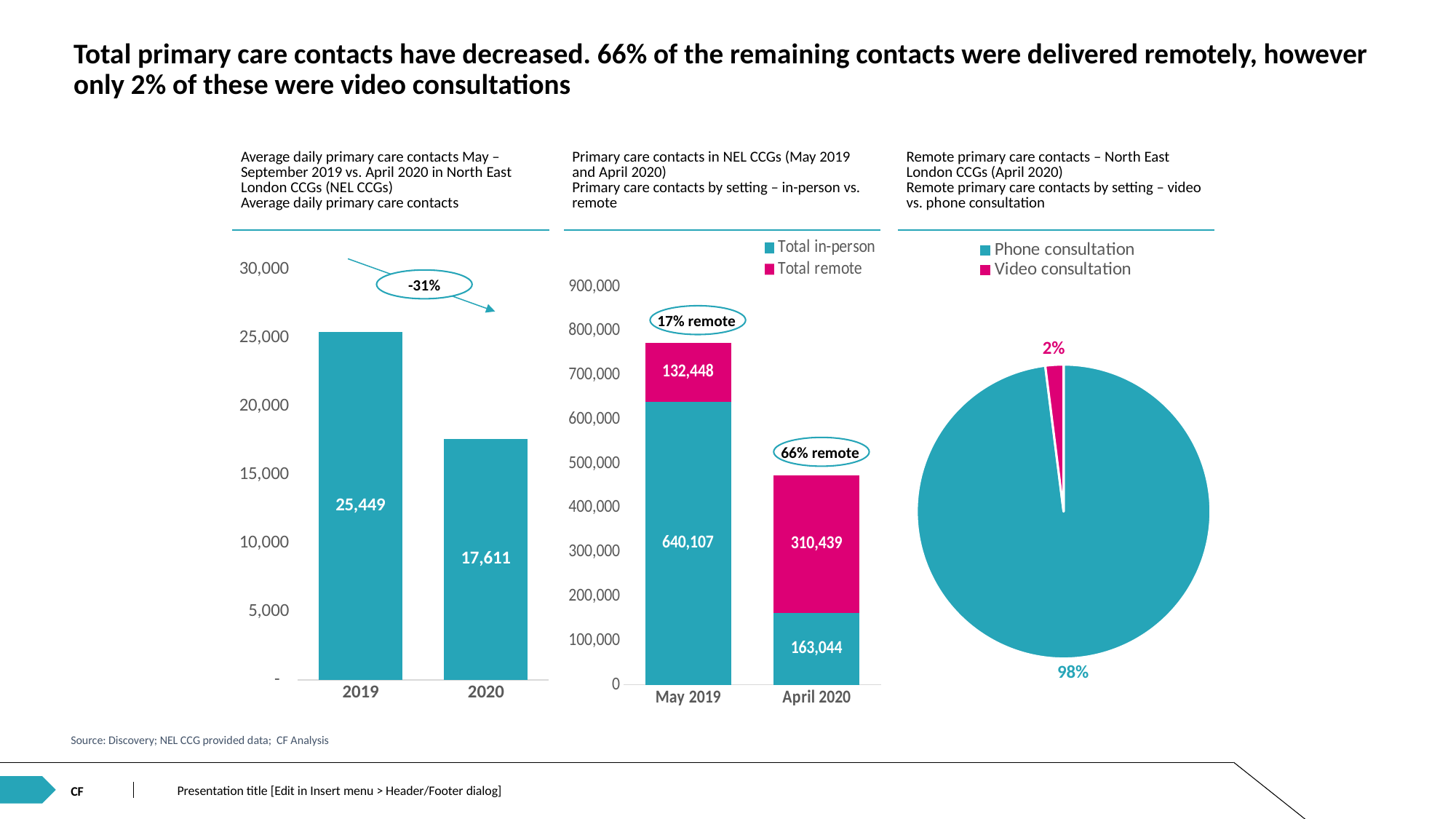
In the middle chart (Primary care contacts by setting), what is the total of the stacked bar for April 2020? 473,483 In the middle chart (Primary care contacts by setting), how many series does the legend list? 2 In the left chart (Average daily primary care contacts), what is the value for 2020? 17,611 In the middle chart (Primary care contacts by setting), what is the Total in-person value for April 2020? 163,044 In the middle chart (Primary care contacts by setting), what is the Total remote value for May 2019? 132,448 In the left chart (Average daily primary care contacts), what is the value for 2019? 25,449 In the middle chart (Primary care contacts by setting), what is the total of the stacked bar for May 2019? 772,555 What kind of chart is the right chart (Remote primary care contacts by setting)? pie chart In the left chart (Average daily primary care contacts), do the values rise or fall from 2019 to 2020? fall In the right chart (Remote primary care contacts by setting), what share of the pie is Video consultation? 2% In the left chart (Average daily primary care contacts), what is the difference between the 2019 and 2020 values? 7,838 In the middle chart (Primary care contacts by setting), which is larger for April 2020: Total in-person or Total remote? Total remote